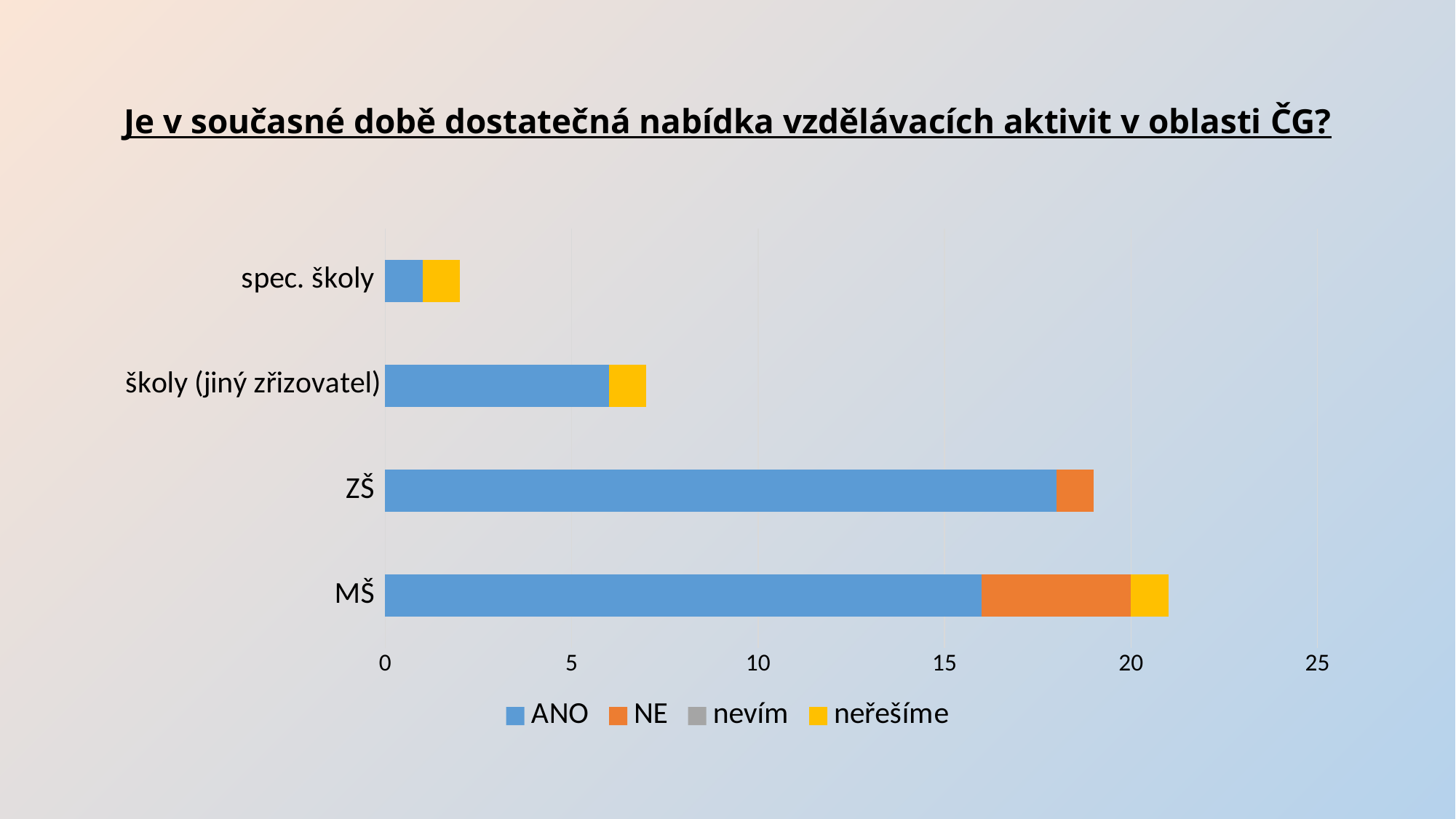
How many categories are shown on the vertical axis of the chart? 4 Is the total bar length for ZŠ greater or less than 20? less Which has the longer total bar, ZŠ or školy (jiný zřizovatel)? ZŠ Which legend series has no visible segment in any bar? nevím How many series does the legend list? 4 Which category has the shortest total bar? spec. školy Is the total bar length for MŠ greater or less than 20? greater Is the ANO value for ZŠ greater or less than 15? greater What kind of chart is shown on the slide? stacked bar chart Which category has the larger NE segment, MŠ or ZŠ? MŠ Which category has the longest total bar? MŠ